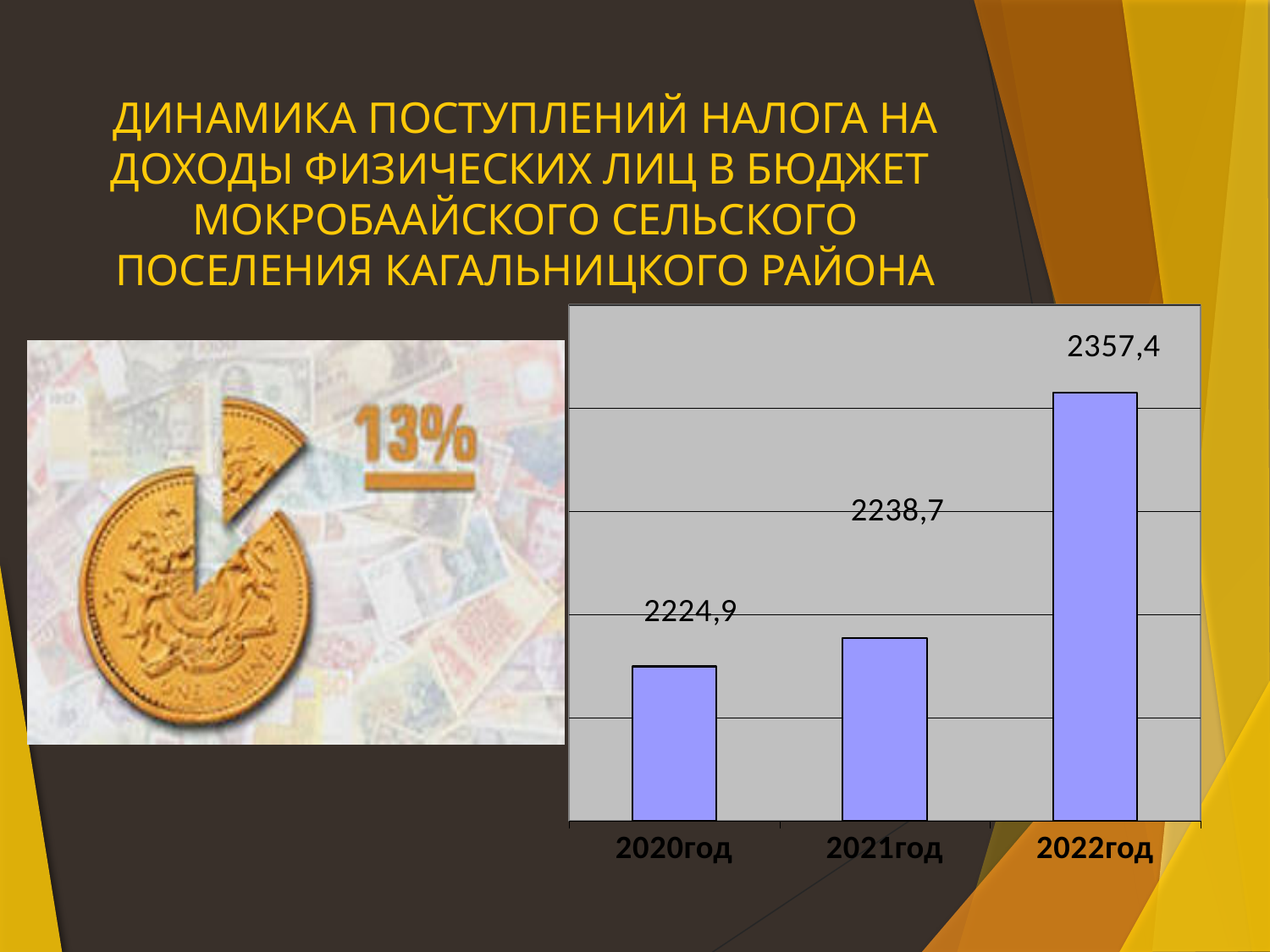
What is the value shown for 2021год? 2238,7 Which year has the lowest value? 2020год What is the difference between the values for 2021год and 2020год? 13,8 What kind of chart is shown on the slide? Bar chart What is the difference between the values for 2022год and 2020год? 132,5 What is the value shown for 2022год? 2357,4 What is the difference between the values for 2022год and 2021год? 118,7 Which is larger, the value for 2021год or the value for 2022год? 2022год Which year has the highest value? 2022год Do the values rise or fall from 2020год to 2022год? Rise What is the value shown for 2020год? 2224,9 How many years are shown on the chart? 3